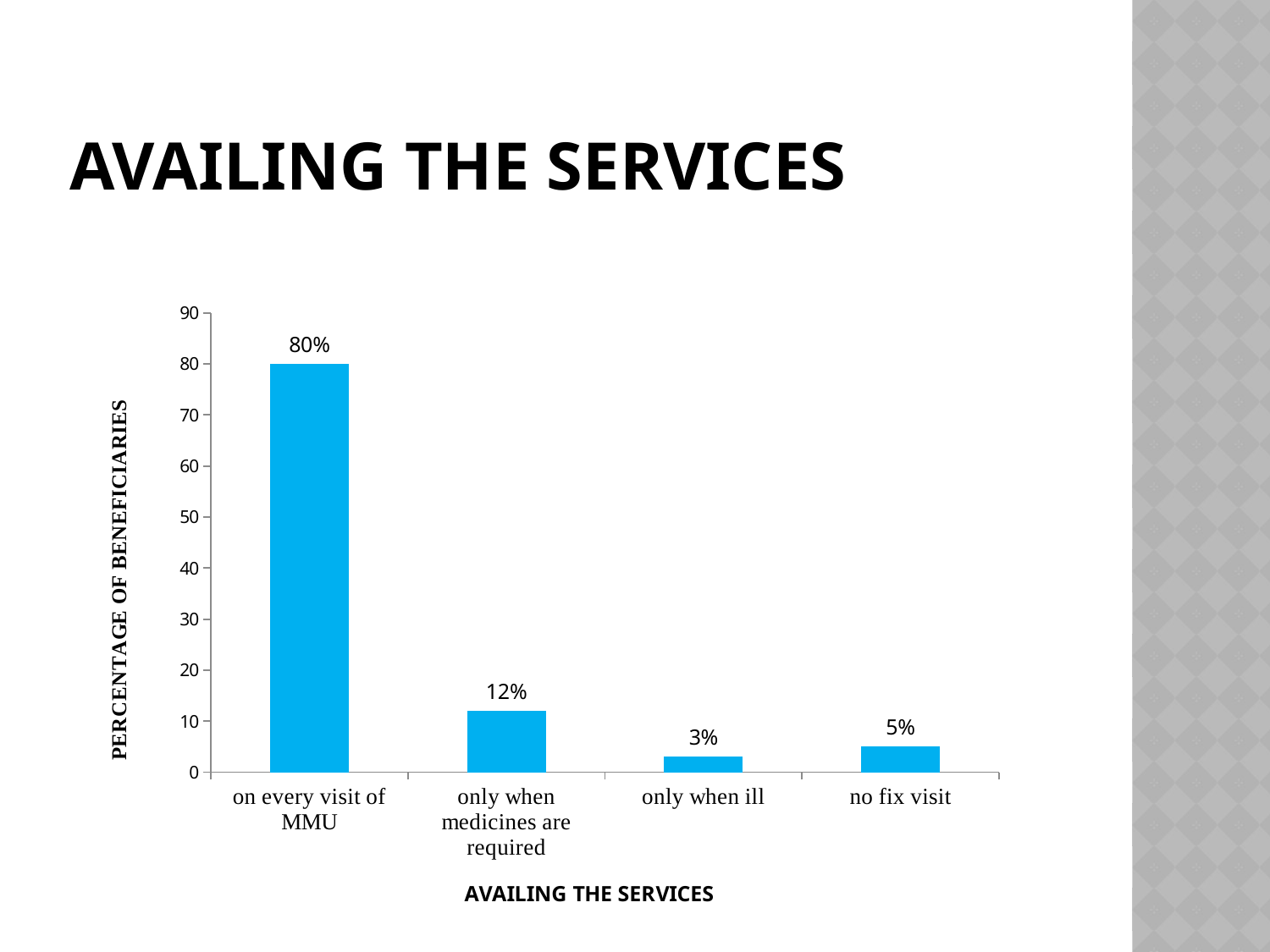
Is the value for 'only when medicines are required' greater or less than 10? greater What is the label of the y axis? PERCENTAGE OF BENEFICIARIES What kind of chart is shown on the slide? bar chart Which category has the lowest percentage of beneficiaries? only when ill What percentage of beneficiaries avail the services on every visit of MMU? 80% Which is larger: the value for 'no fix visit' or the value for 'only when ill'? no fix visit What is the difference in percentage points between 'on every visit of MMU' and 'only when medicines are required'? 68 What percentage of beneficiaries have no fix visit? 5% What percentage of beneficiaries avail the services only when ill? 3% What percentage of beneficiaries avail the services only when medicines are required? 12% How many categories are shown on the x axis? 4 Which category has the highest percentage of beneficiaries? on every visit of MMU